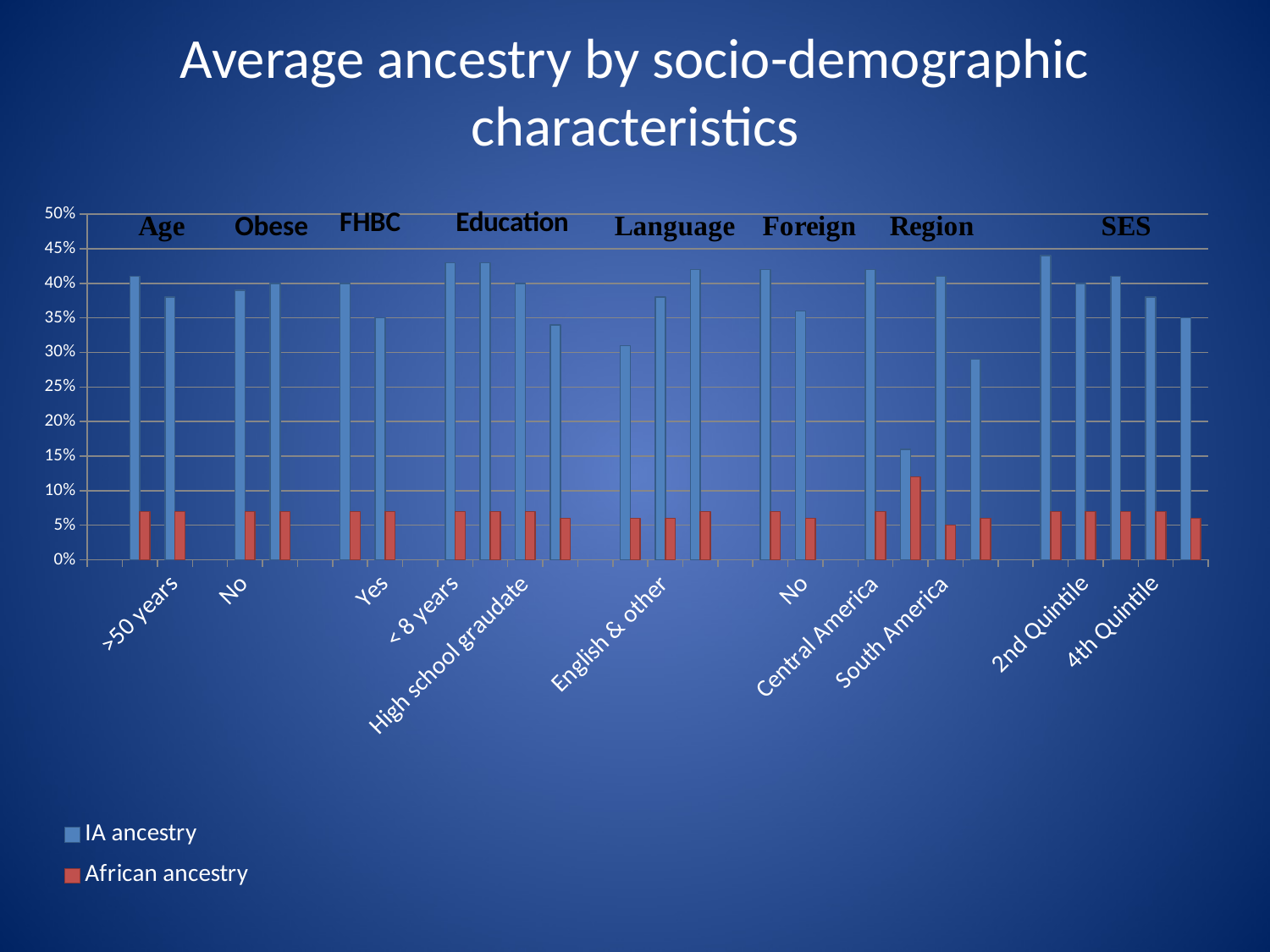
Is the IA ancestry value for "4th Quintile" greater or less than 40%? less What is the title of the chart? Average ancestry by socio-demographic characteristics For ">50 years", which series has the larger value, IA ancestry or African ancestry? IA ancestry Which series is shown in blue in the legend? IA ancestry What kind of chart is shown on the slide? bar chart How many series does the legend list? 2 Which has the larger IA ancestry value, "< 8 years" or "High school graduate"? < 8 years Is the IA ancestry value for ">50 years" greater or less than 35%? greater Is the IA ancestry value for "< 8 years" greater or less than 40%? greater